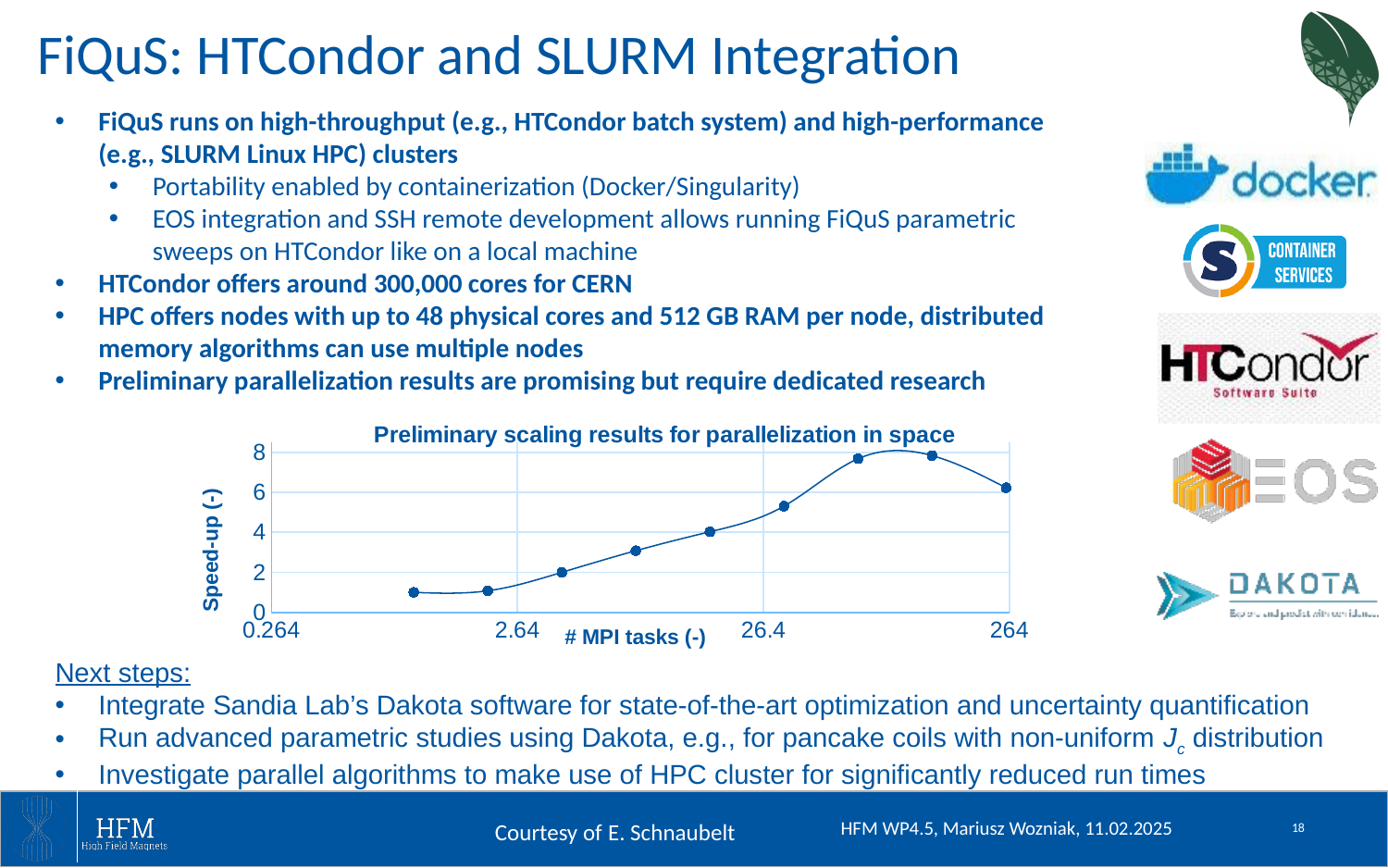
Is the speed-up at 264 MPI tasks greater or less than 4? greater How many data series are plotted on the chart? 1 Is the speed-up at the leftmost data point greater or less than 2? less What is the highest value shown on the y axis of the chart? 8 Which is larger: the speed-up at the leftmost data point or at 264 MPI tasks? 264 MPI tasks Is the speed-up at 264 MPI tasks greater or less than 8? less Does the speed-up rise or fall as the number of MPI tasks increases from 2.64 to 26.4? rise What is the label of the x axis of the chart? # MPI tasks (-) What is the title of the chart? Preliminary scaling results for parallelization in space What kind of chart is shown on the slide? line chart How many data points are plotted on the chart? 9 Is the speed-up at the rightmost point (264 MPI tasks) higher or lower than the peak speed-up on the chart? lower